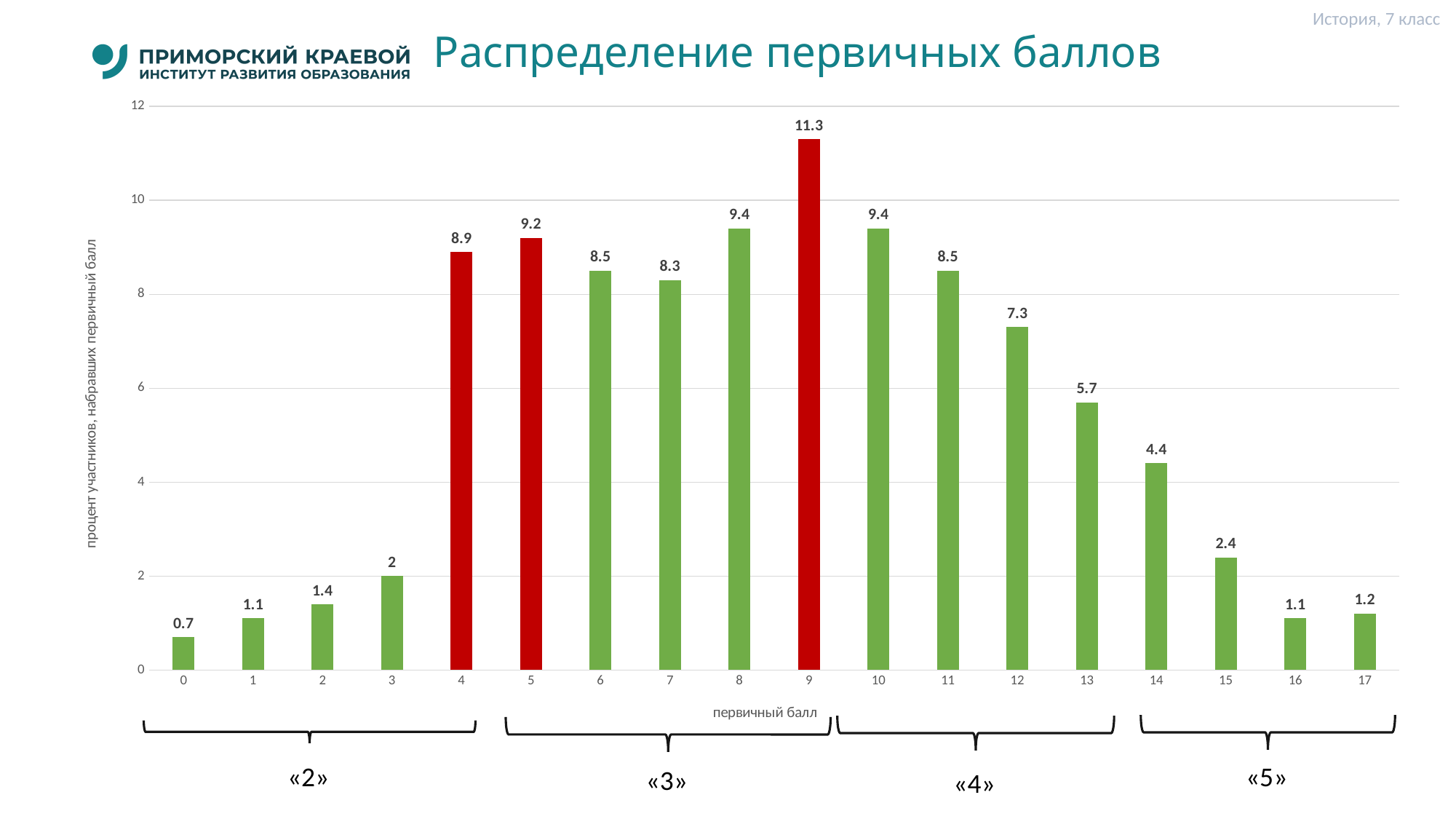
Which is larger, the value for primary score 5 or for primary score 6? 5 What is the difference between the values for primary scores 9 and 4? 2.4 What is the value for primary score 0? 0.7 Is the value for primary score 12 greater or less than 8? less What is the value for primary score 13? 5.7 How many primary score categories are shown on the x axis? 18 What kind of chart is shown on the slide? bar chart Which primary score has the highest percentage of participants? 9 What is the value for primary score 9? 11.3 Which primary score has the lowest percentage of participants? 0 How many bars are coloured red? 3 Do the values rise or fall from primary score 9 to primary score 17? fall